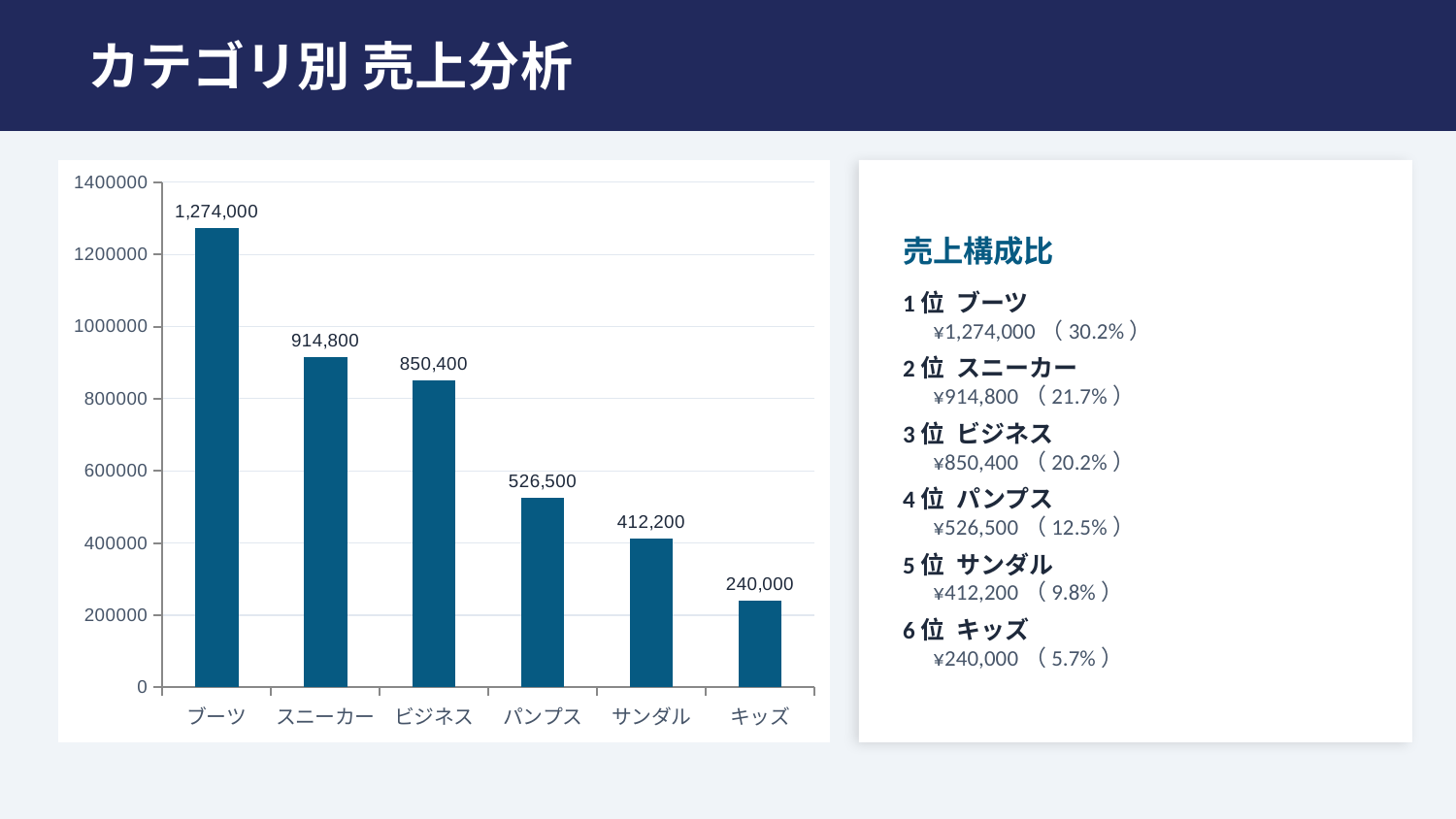
Which is larger, the value for パンプス or the value for サンダル? パンプス What is the difference between the values for サンダル and キッズ? 172,200 Which category has the lowest value? キッズ What is the value for パンプス? 526,500 Is the value for ビジネス greater or less than 800000? greater What is the difference between the values for スニーカー and ビジネス? 64,400 How many categories are shown on the x axis? 6 What kind of chart is shown on the slide? bar chart Do the values rise or fall from left to right along the x axis? fall Which category has the highest value? ブーツ What is the value for ブーツ? 1,274,000 What is the value for キッズ? 240,000